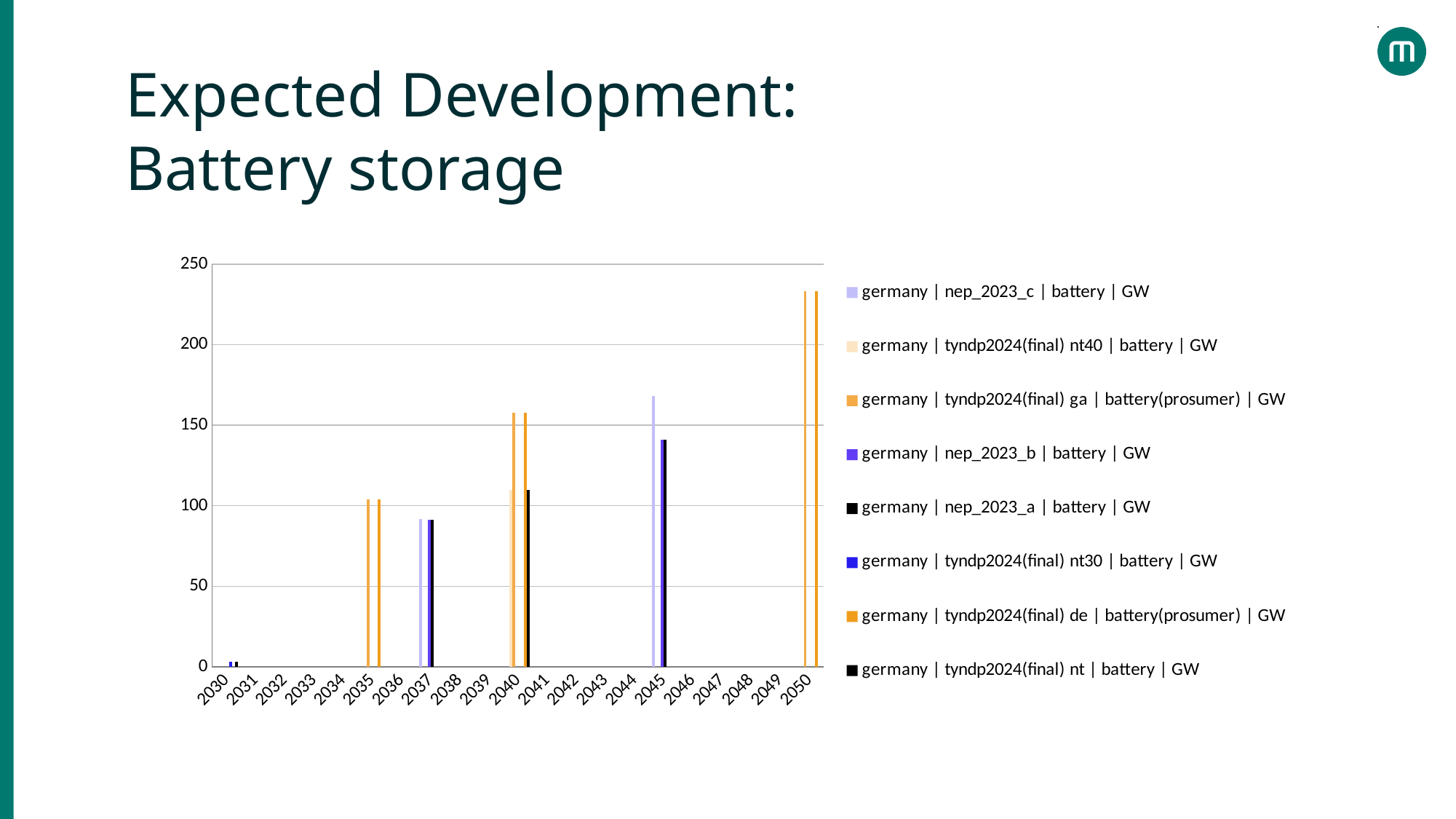
Is the value of the black bar for 2045 greater or less than 150? less Is the value of the light purple bar (germany | nep_2023_c | battery | GW) for 2045 greater or less than 150? greater Are the orange bars for 2050 greater or less than 200? greater Which year has the tallest bar in the chart? 2050 How many series does the legend list? 8 What kind of chart is shown on the slide? bar chart What unit is given at the end of every legend entry? GW Which is larger in 2045: the light purple bar (nep_2023_c) or the black bar (nep_2023_a)? the light purple bar (nep_2023_c) How many year categories are shown on the x axis? 21 Do the tallest bars generally rise or fall from 2030 to 2050? rise